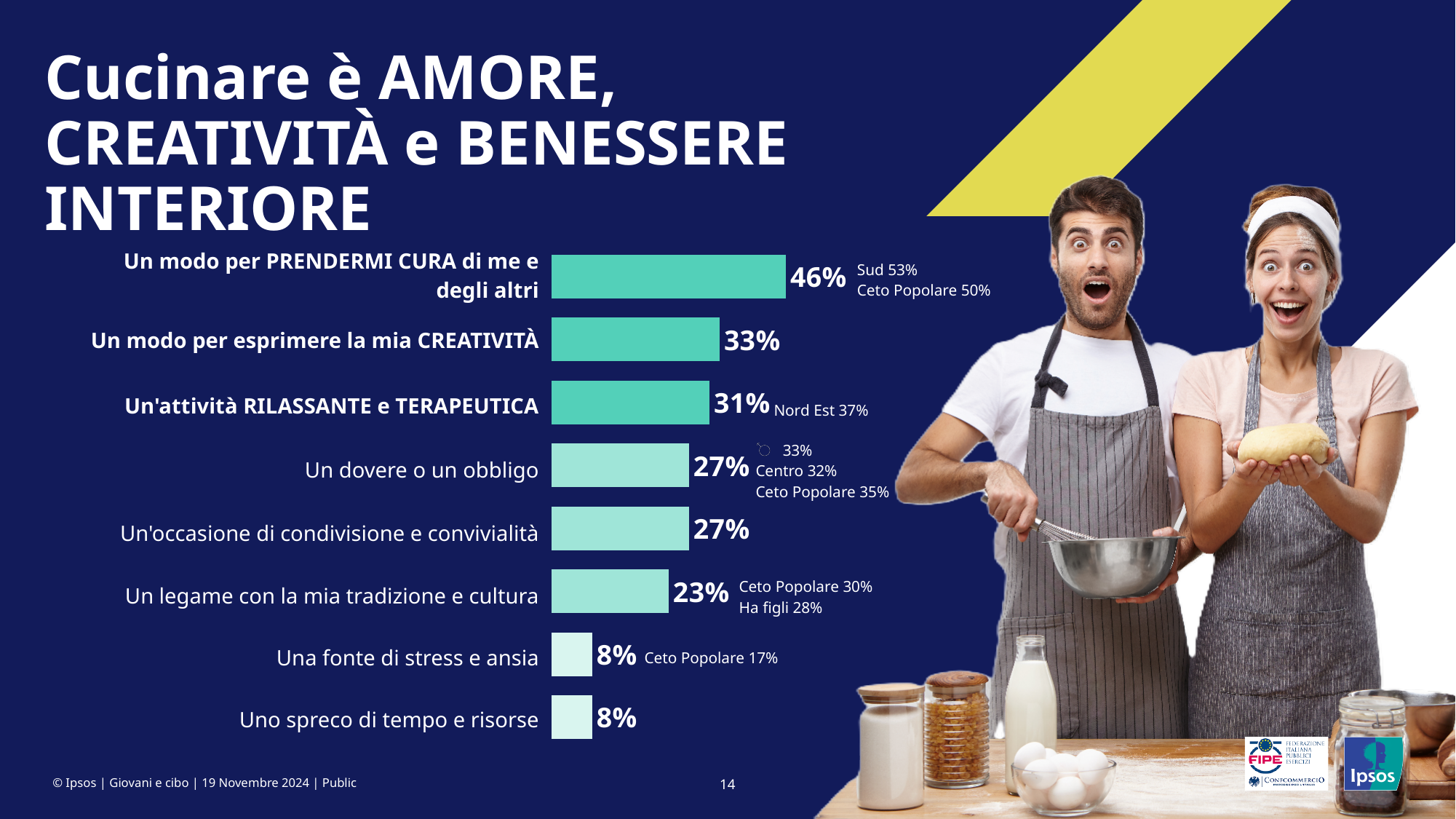
What kind of chart is shown on the slide? Bar chart What value is annotated for "Sud" next to the bar for "Un modo per PRENDERMI CURA di me e degli altri"? 53% How many categories are shown in the chart? 8 What is the value for "Un'attività RILASSANTE e TERAPEUTICA"? 31% What is the value for "Una fonte di stress e ansia"? 8% What is the value for "Un modo per PRENDERMI CURA di me e degli altri"? 46% What is the value for "Un legame con la mia tradizione e cultura"? 23% Which category has the highest value? Un modo per PRENDERMI CURA di me e degli altri What is the difference between the values for "Un modo per PRENDERMI CURA di me e degli altri" and "Un modo per esprimere la mia CREATIVITÀ"? 13% What is the value for "Un modo per esprimere la mia CREATIVITÀ"? 33% What is the difference between the values for "Un legame con la mia tradizione e cultura" and "Uno spreco di tempo e risorse"? 15% Which is larger: the value for "Un'attività RILASSANTE e TERAPEUTICA" or the value for "Un dovere o un obbligo"? Un'attività RILASSANTE e TERAPEUTICA